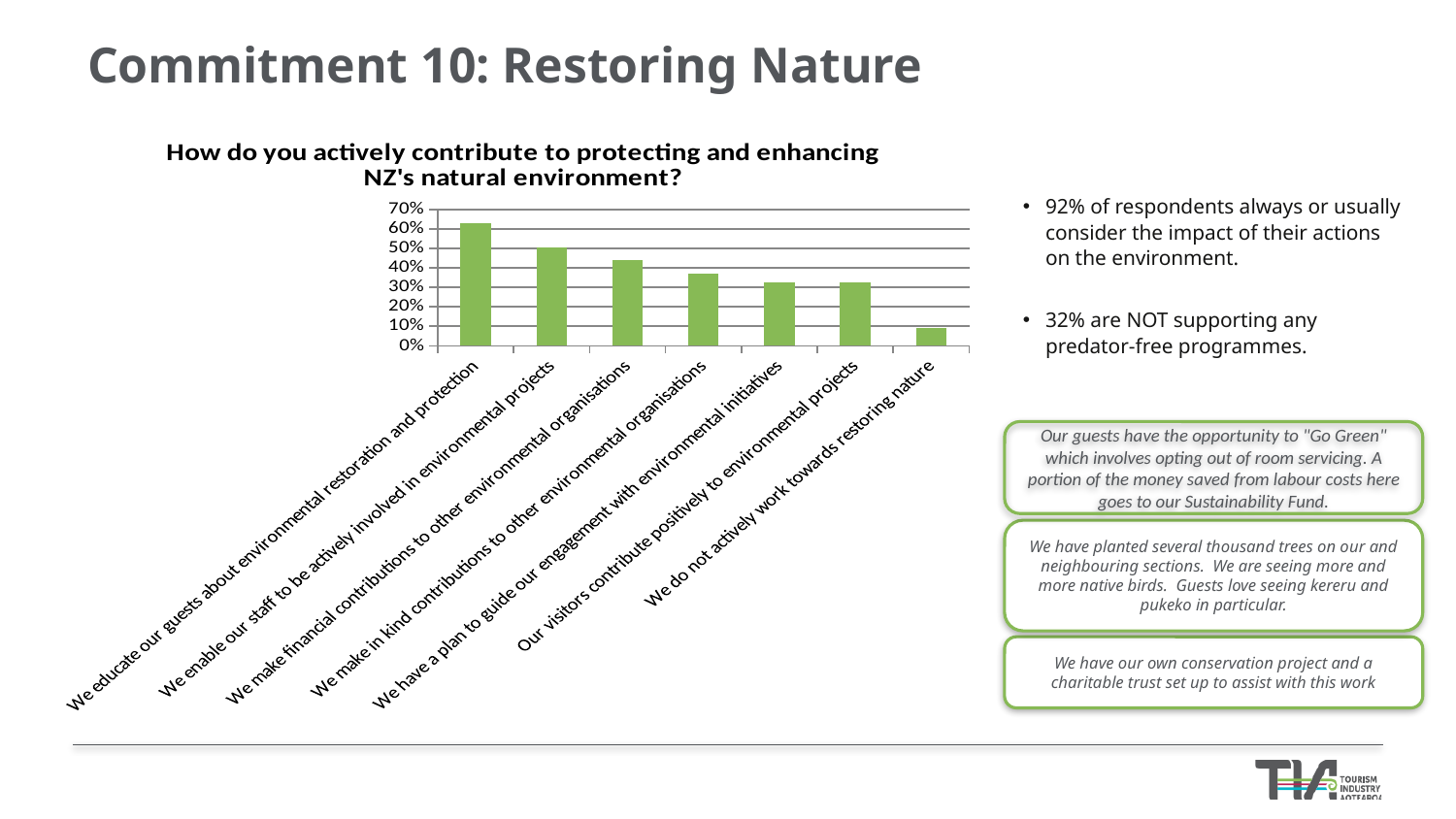
Is the value for "We make financial contributions to other environmental organisations" greater or less than 40%? greater What kind of chart is shown on the slide? bar chart Which is larger: the value for "We enable our staff to be actively involved in environmental projects" or the value for "We make in kind contributions to other environmental organisations"? We enable our staff to be actively involved in environmental projects How many categories are plotted in the chart? 7 Do the bar values generally rise or fall from left to right along the x axis? fall Which category has the highest value in the chart? We educate our guests about environmental restoration and protection What is the title of the chart? How do you actively contribute to protecting and enhancing NZ's natural environment? Which category has the lowest value in the chart? We do not actively work towards restoring nature Is the value for "We make in kind contributions to other environmental organisations" greater or less than 40%? less Which is larger: the value for "Our visitors contribute positively to environmental projects" or the value for "We do not actively work towards restoring nature"? Our visitors contribute positively to environmental projects Is the value for "We educate our guests about environmental restoration and protection" greater or less than 60%? greater